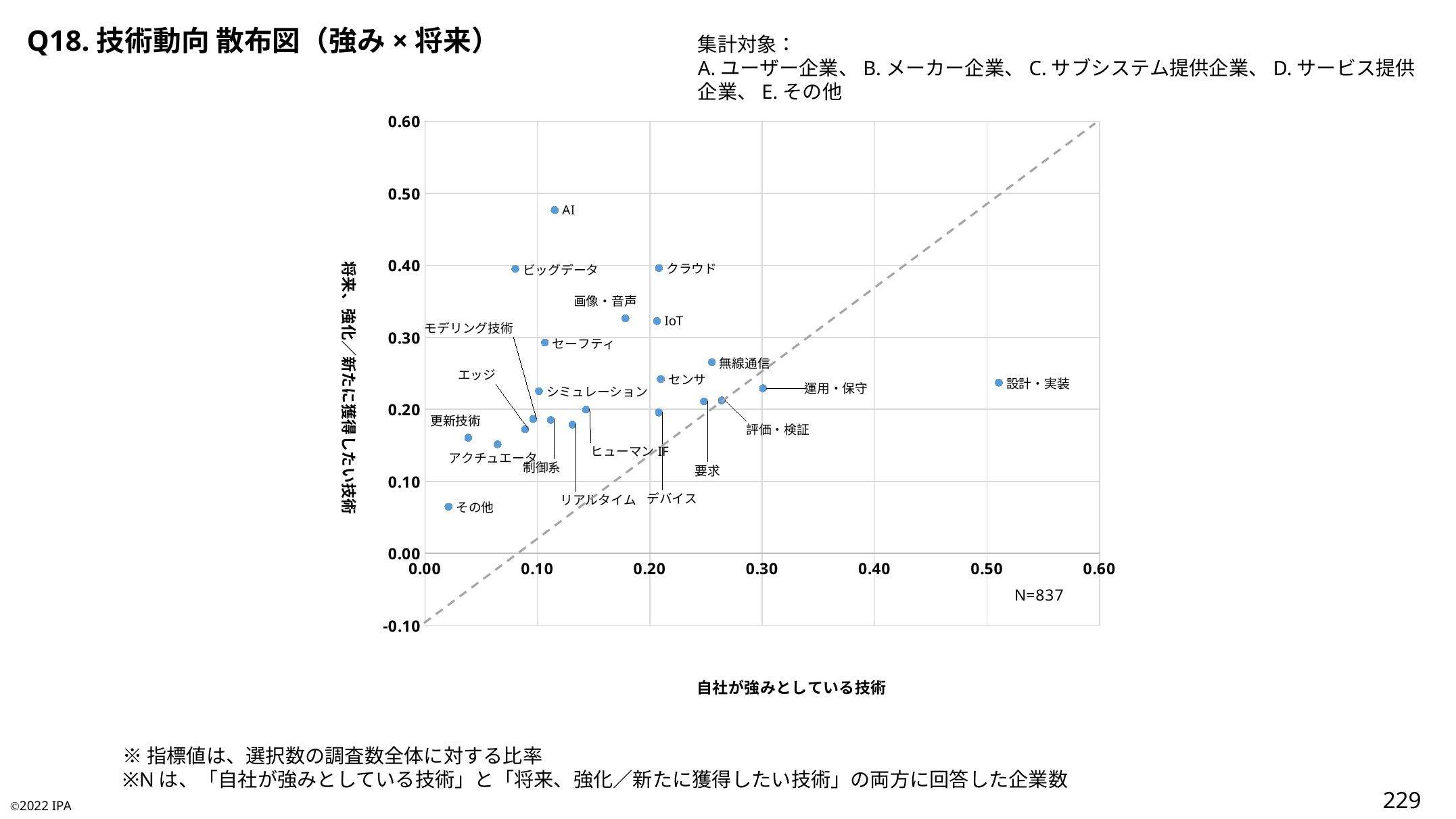
Which has the larger vertical-axis value, 無線通信 or センサ? 無線通信 Which technology has the highest value on the vertical axis (将来、強化／新たに獲得したい技術)? AI Which technology has the lowest value on the horizontal axis? その他 Which technology has the lowest value on the vertical axis? その他 Is the vertical-axis value for その他 greater or less than 0.10? less Is the vertical-axis value for AI greater or less than 0.40? greater Is the horizontal-axis value for 設計・実装 greater or less than 0.40? greater What kind of chart is shown on the slide? scatter chart What is the title of the horizontal axis? 自社が強みとしている技術 What is the N value shown on the chart? N=837 Which technology has the highest value on the horizontal axis (自社が強みとしている技術)? 設計・実装 Which has the larger horizontal-axis value, ビッグデータ or クラウド? クラウド